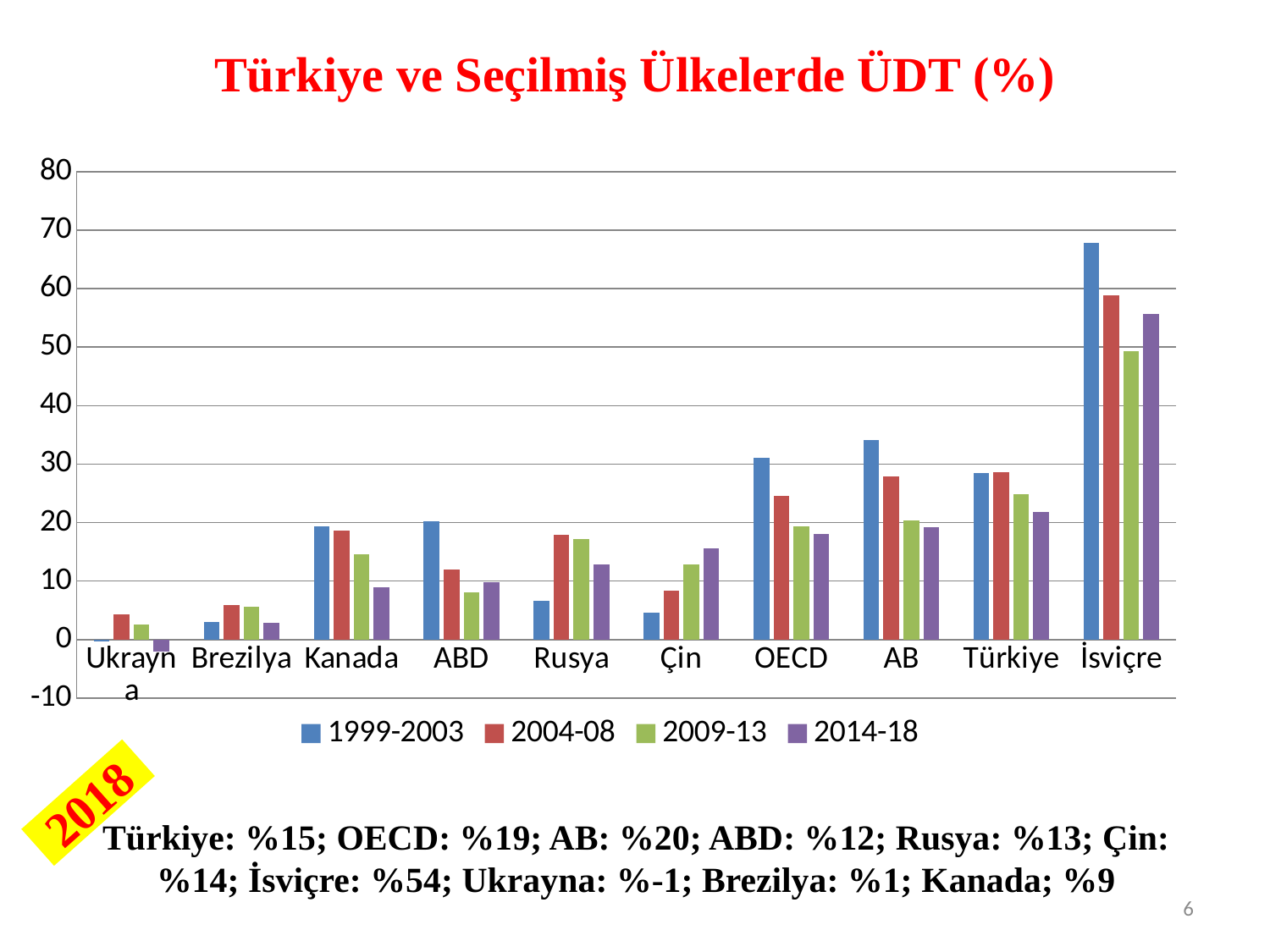
Which category has the highest value for the 1999-2003 series? İsviçre Is the 1999-2003 value for AB greater or less than 30? greater How many countries or groups are shown on the x axis of the chart? 10 What is the title of the chart on the slide? Türkiye ve Seçilmiş Ülkelerde ÜDT (%) Is the 2004-08 value for ABD greater or less than 20? less How many series does the legend list? 4 For İsviçre, which is larger: the 1999-2003 value or the 2004-08 value? 1999-2003 Is the 2014-18 value for Ukrayna greater or less than 0? less Which category has the lowest value for the 2014-18 series? Ukrayna What kind of chart is shown on the slide? bar chart For Çin, do the values rise or fall from the 1999-2003 series to the 2014-18 series? rise